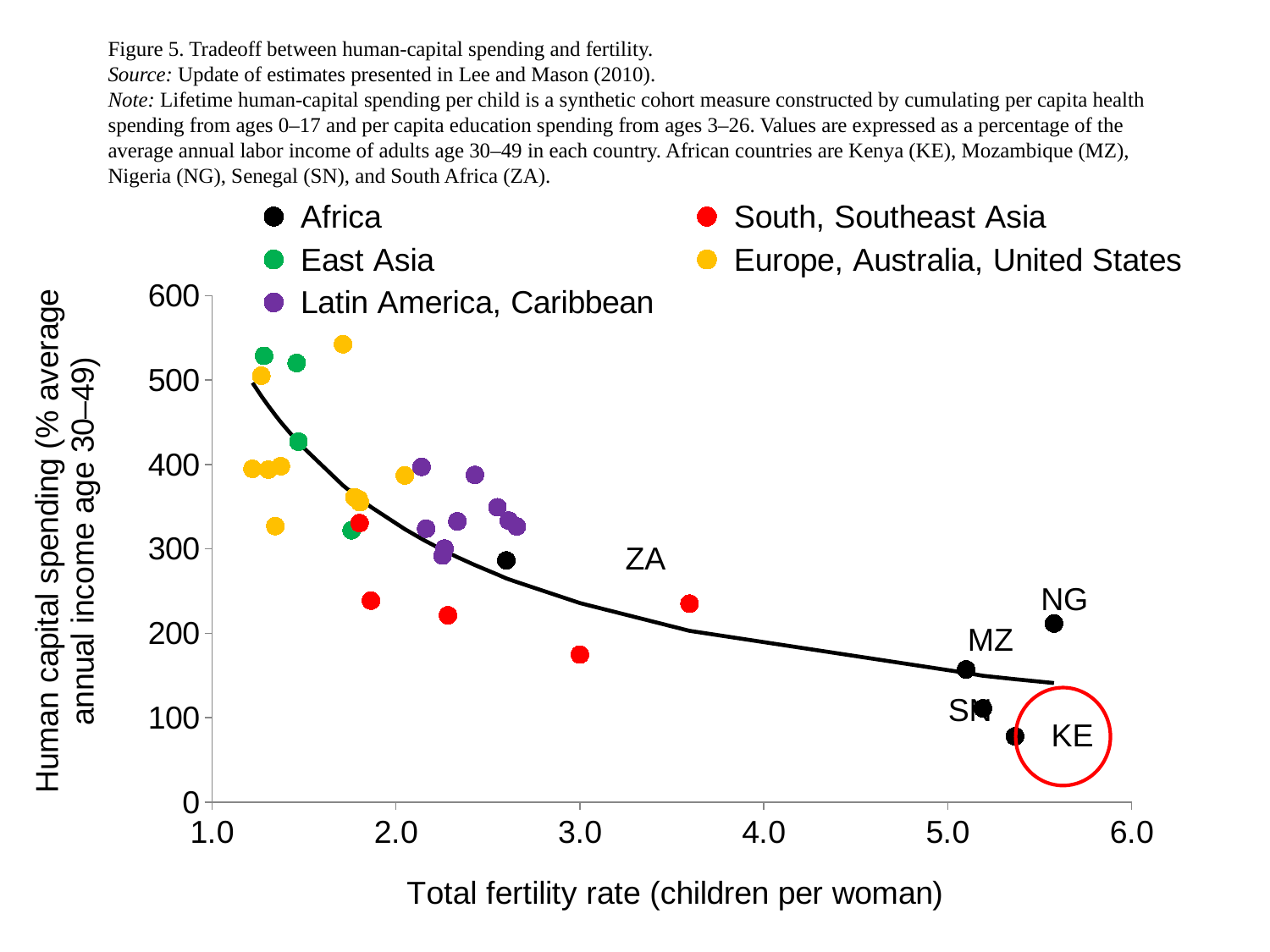
How many series (regions) does the legend list? 5 Is the human capital spending value for KE greater or less than 100? less Is the human capital spending value for NG greater or less than 150? greater Which of the labeled African countries has the lowest human capital spending? KE Is the human capital spending value for MZ greater or less than 200? less What kind of chart is shown on the slide? Scatter chart As the total fertility rate increases along the x axis, does human capital spending generally rise or fall? Fall Which country's point is circled in red? KE What colour are the points for Africa in the legend? Black Which has higher human capital spending, NG or KE? NG